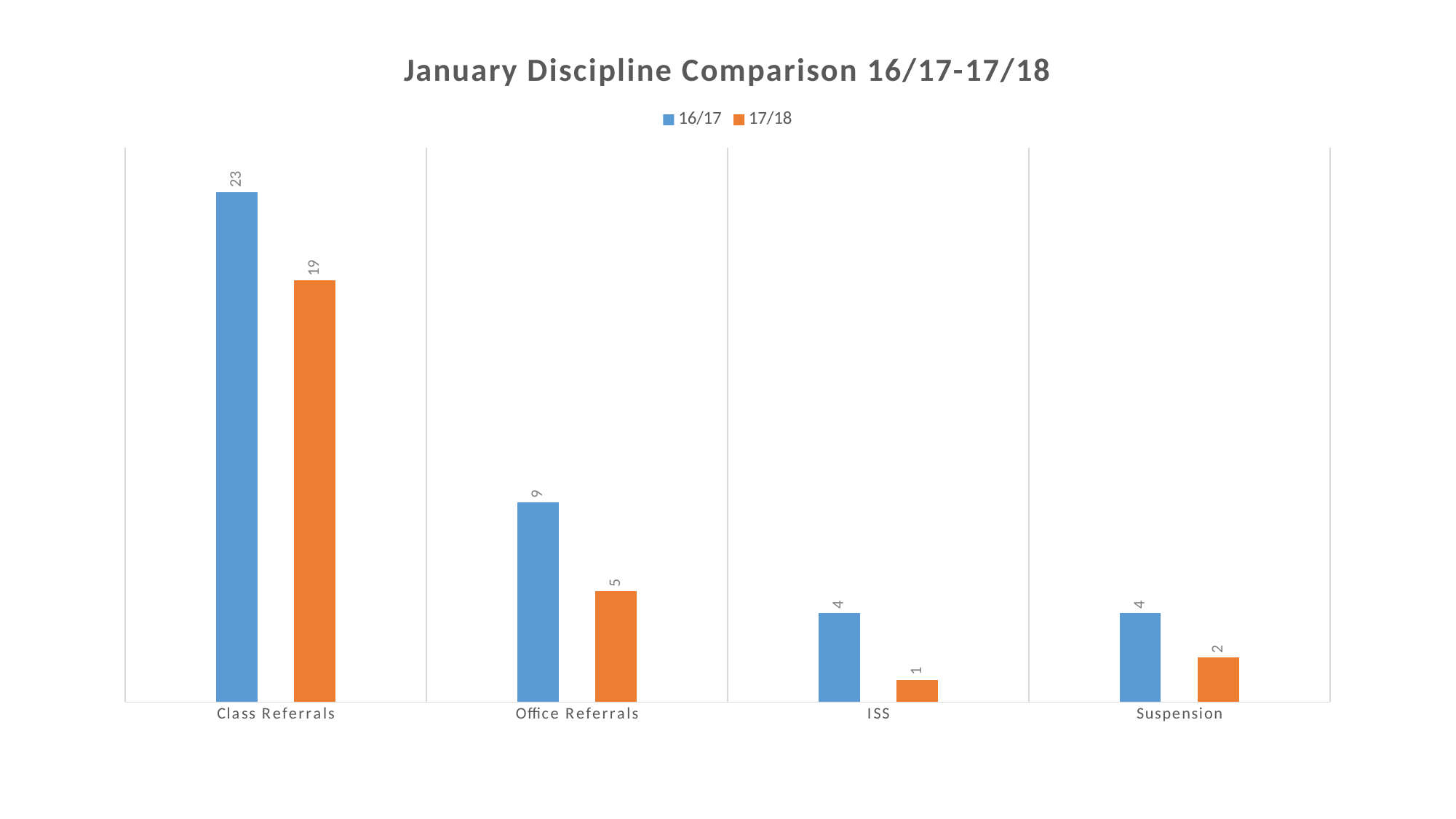
What is the 16/17 value for Suspension? 4 Which category has the lowest 17/18 value? ISS How many categories are shown on the x axis? 4 What kind of chart is shown on the slide? Bar chart What is the difference between the 16/17 and 17/18 values for Office Referrals? 4 Which category has the highest 17/18 value? Class Referrals What is the 17/18 value for ISS? 1 What is the difference between the 16/17 and 17/18 values for Class Referrals? 4 How many series does the legend list? 2 What is the 17/18 value for Office Referrals? 5 What is the 16/17 value for Class Referrals? 23 Which is larger for Suspension, the 16/17 value or the 17/18 value? 16/17